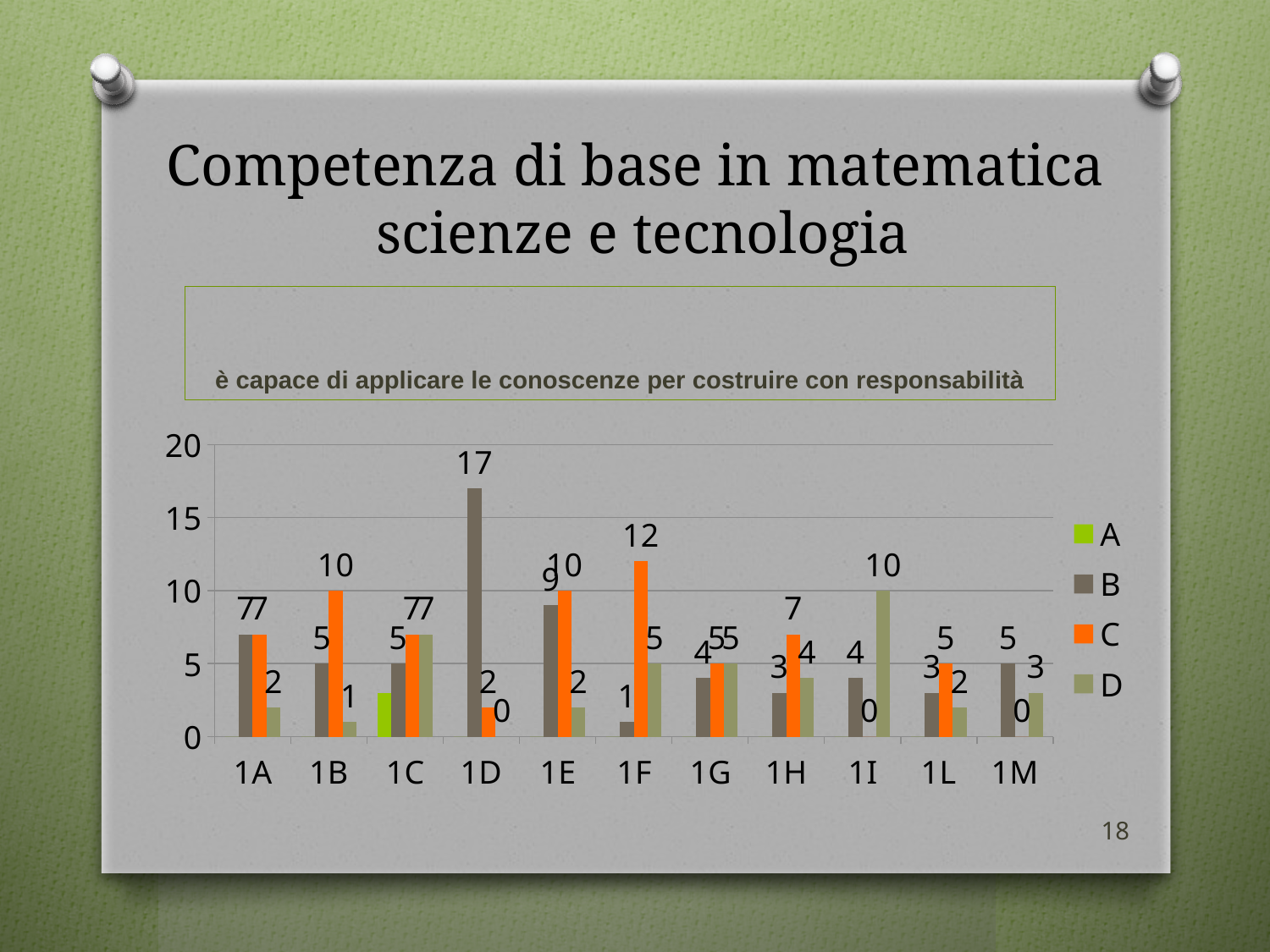
What is the value of series C for category 1F? 12 What kind of chart is shown on the slide? bar chart Which category has the lowest value for series D? 1D How many categories are shown on the x axis? 11 For category 1B, which is larger: series B or series C? C What is the value of series C for category 1I? 0 Is the value of series A for category 1C greater or less than 5? less What is the value of series B for category 1D? 17 Which category has the highest value for series B? 1D What is the difference between series B and series C for category 1D? 15 How many series does the legend list? 4 What is the value of series D for category 1I? 10